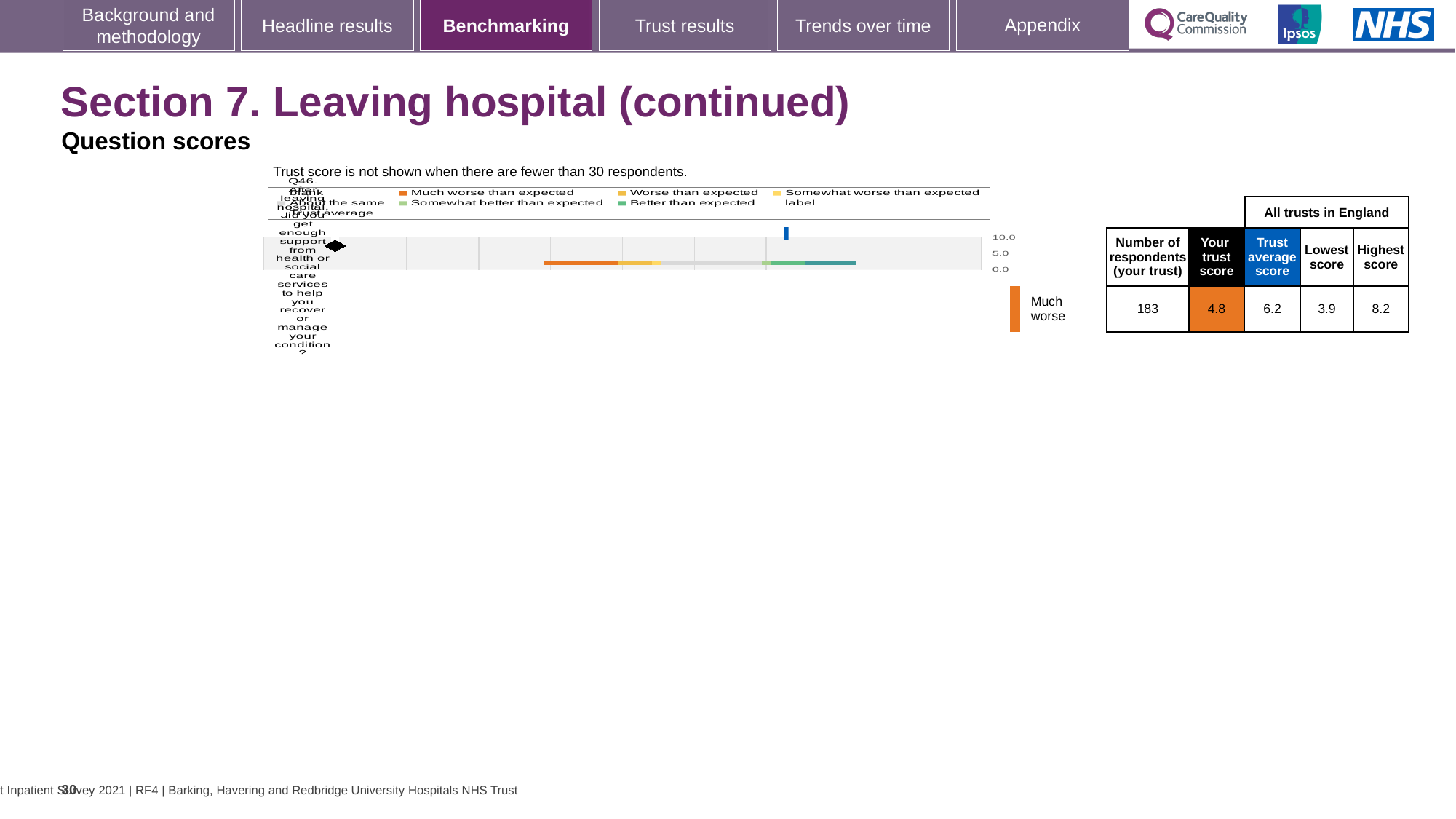
Which benchmarking category is the trust's Q46 result placed in, as labelled next to the chart? Much worse Which is larger for Q46: the trust's own score or the trust average score? Trust average score What is the highest score among all trusts in England for Q46? 8.2 How much lower is the trust's score for Q46 than the trust average score? 1.4 What kind of chart is used to show the Q46 benchmarking result? Bar chart What is the trust score for Q46 shown in the table? 4.8 What is the lowest score among all trusts in England for Q46? 3.9 What is the trust average score for Q46 across all trusts in England? 6.2 How many respondents from the trust answered Q46? 183 According to the note above the chart, below how many respondents is the trust score not shown? 30 What is the difference between the highest and lowest scores for Q46 across all trusts in England? 4.3 Is the trust's score for Q46 greater or less than 5.0 on the chart axis? less